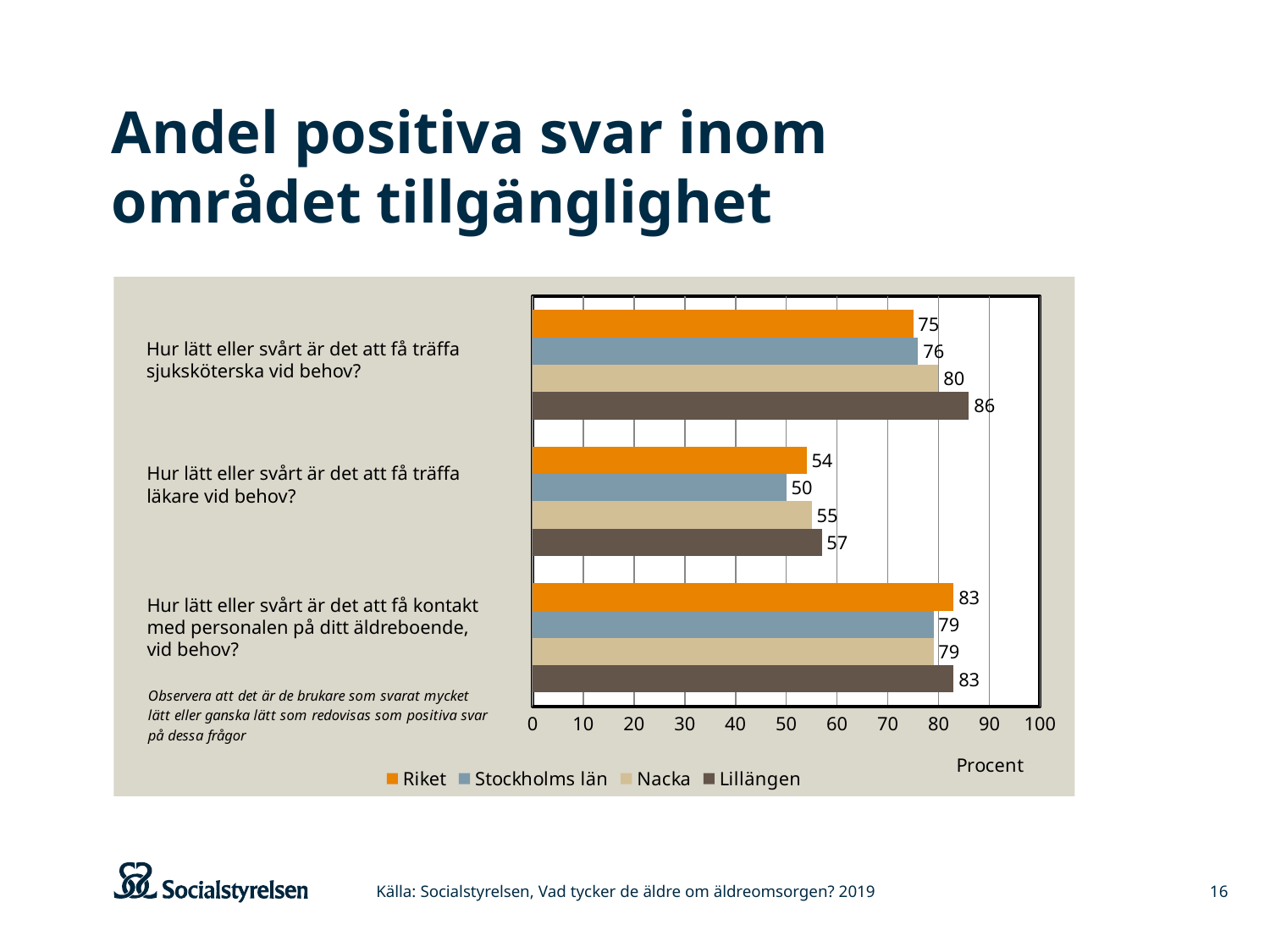
How many series does the legend list? 4 How many question categories are plotted on the chart? 3 Which series has the lowest value for the question "Hur lätt eller svårt är det att få träffa läkare vid behov?"? Stockholms län What is the value for Lillängen for the question "Hur lätt eller svårt är det att få träffa sjuksköterska vid behov?"? 86 What is the difference between Riket and Stockholms län for the question "Hur lätt eller svårt är det att få kontakt med personalen på ditt äldreboende, vid behov?"? 4 What is the value for Stockholms län for the question "Hur lätt eller svårt är det att få träffa läkare vid behov?"? 50 What is the value for Riket for the question about getting in contact with staff at the äldreboende ("Hur lätt eller svårt är det att få kontakt med personalen på ditt äldreboende, vid behov?")? 83 What is the difference between Lillängen and Riket for the question "Hur lätt eller svårt är det att få träffa sjuksköterska vid behov?"? 11 What label is shown on the horizontal axis of the chart? Procent What type of chart is shown on the slide? bar chart For the question "Hur lätt eller svårt är det att få träffa läkare vid behov?", which is larger: the value for Nacka or the value for Riket? Nacka Which series has the highest value for the question "Hur lätt eller svårt är det att få träffa sjuksköterska vid behov?"? Lillängen